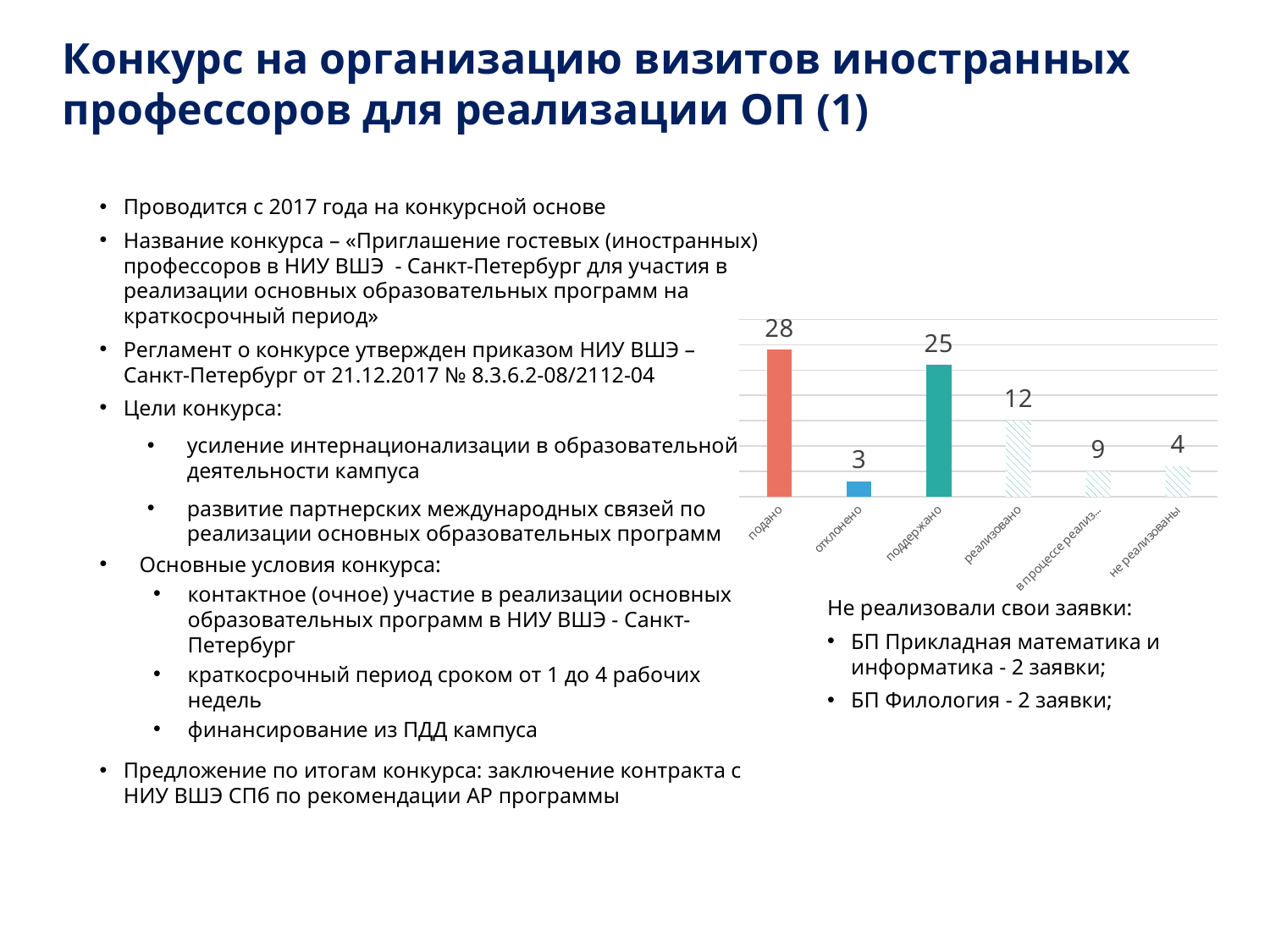
What is the value for "не реализованы" on the bar chart? 4 What is the value for "поддержано" on the bar chart? 25 Which category has the lowest value on the bar chart? отклонено What is the difference between the values for "поддержано" and "реализовано"? 13 What is the difference between the values for "подано" and "поддержано"? 3 What is the value for "подано" on the bar chart? 28 What type of chart is shown on the slide? bar chart How many categories are shown on the bar chart? 6 Which is larger on the bar chart: "реализовано" or "не реализованы"? реализовано Which category has the highest value on the bar chart? подано What is the value for "реализовано" on the bar chart? 12 What is the value for "отклонено" on the bar chart? 3